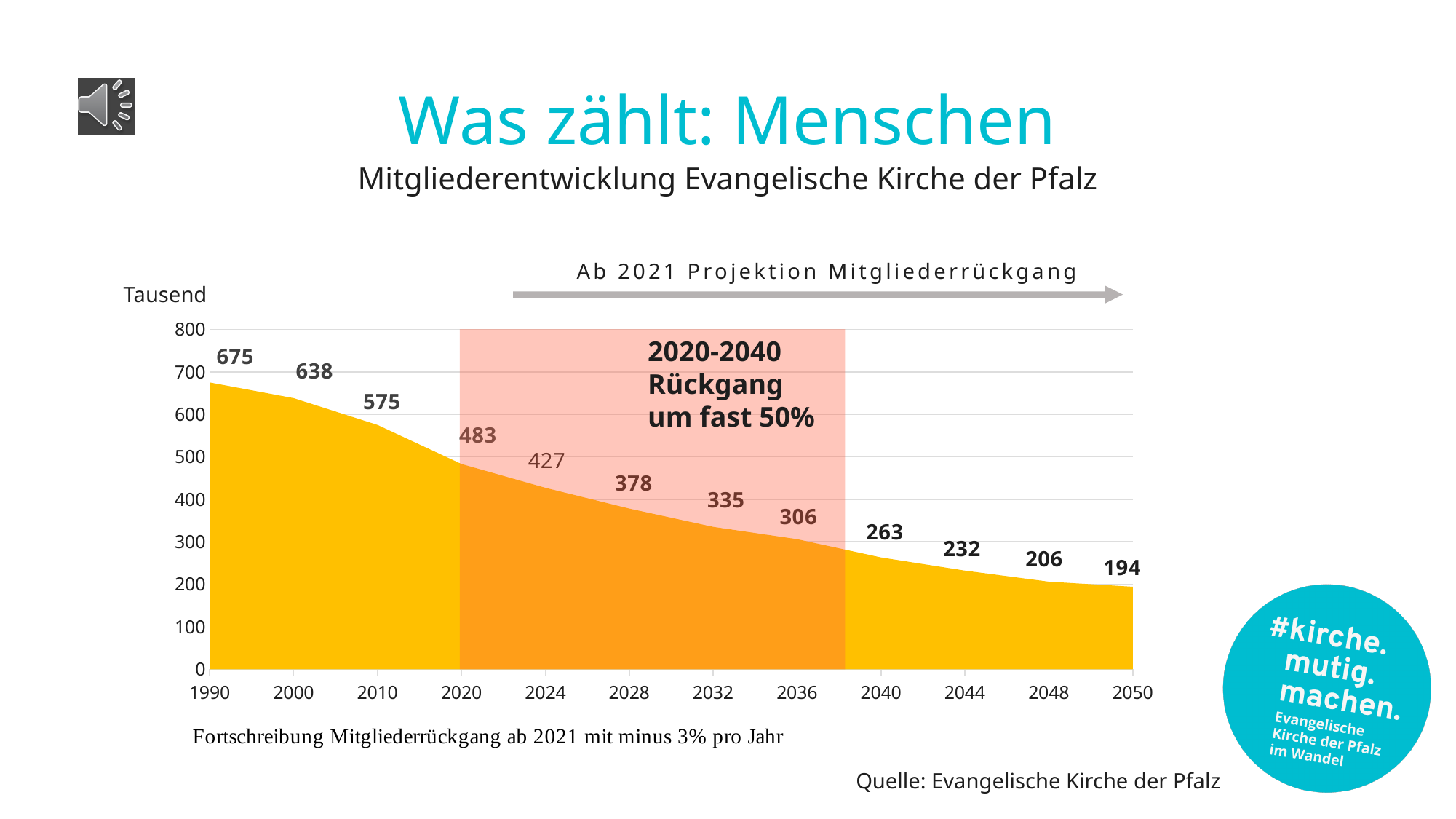
Which year has the highest membership value on the chart? 1990 What kind of chart is shown on the slide? Area chart How many data points are labelled with values on the chart? 12 What is the membership value (in thousands) shown for 2020? 483 What is the difference between the membership values for 2020 and 2040? 220 Which year has the lowest membership value on the chart? 2050 What is the membership value (in thousands) shown for 2050? 194 What is the difference between the membership values for 1990 and 2050? 481 What is the membership value (in thousands) shown for 2036? 306 What is the membership value (in thousands) shown for 1990? 675 Which is larger, the value for 2010 or the value for 2024? 2010 Do the membership values rise or fall from 1990 to 2050? Fall